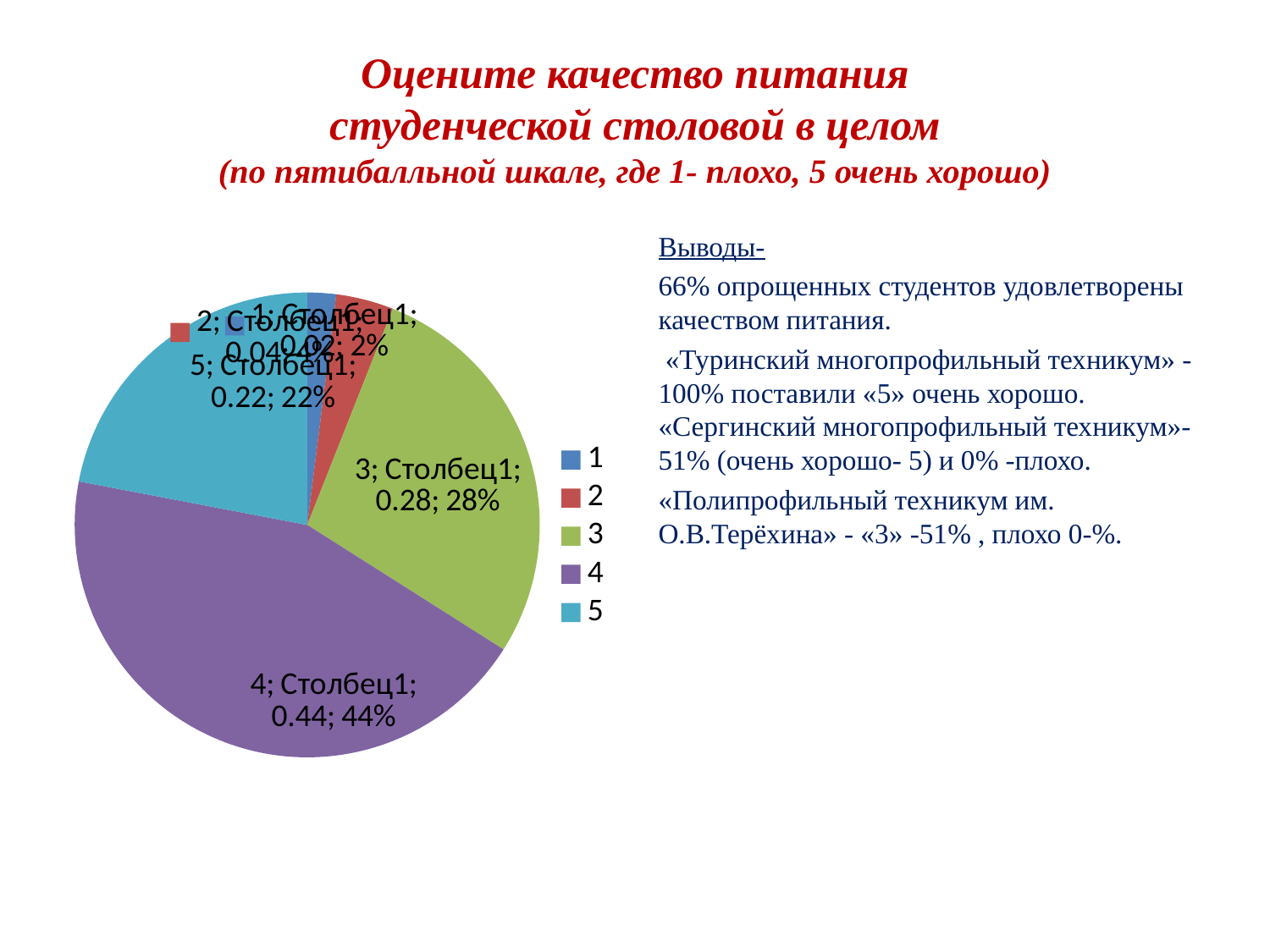
What percentage of the pie does category 3 represent? 28% What colour is the slice for category 4 in the pie chart? purple What kind of chart is shown on the slide? pie chart Which category has the smallest slice of the pie? 1 What is the difference in percentage points between the slices for category 4 and category 3? 16 Which category has the largest slice of the pie? 4 How many entries does the legend of the pie chart list? 5 What percentage of the pie does category 4 represent? 44% Which slice is larger, category 3 or category 5? 3 What percentage of the pie does category 1 represent? 2% How many slices does the pie chart have? 5